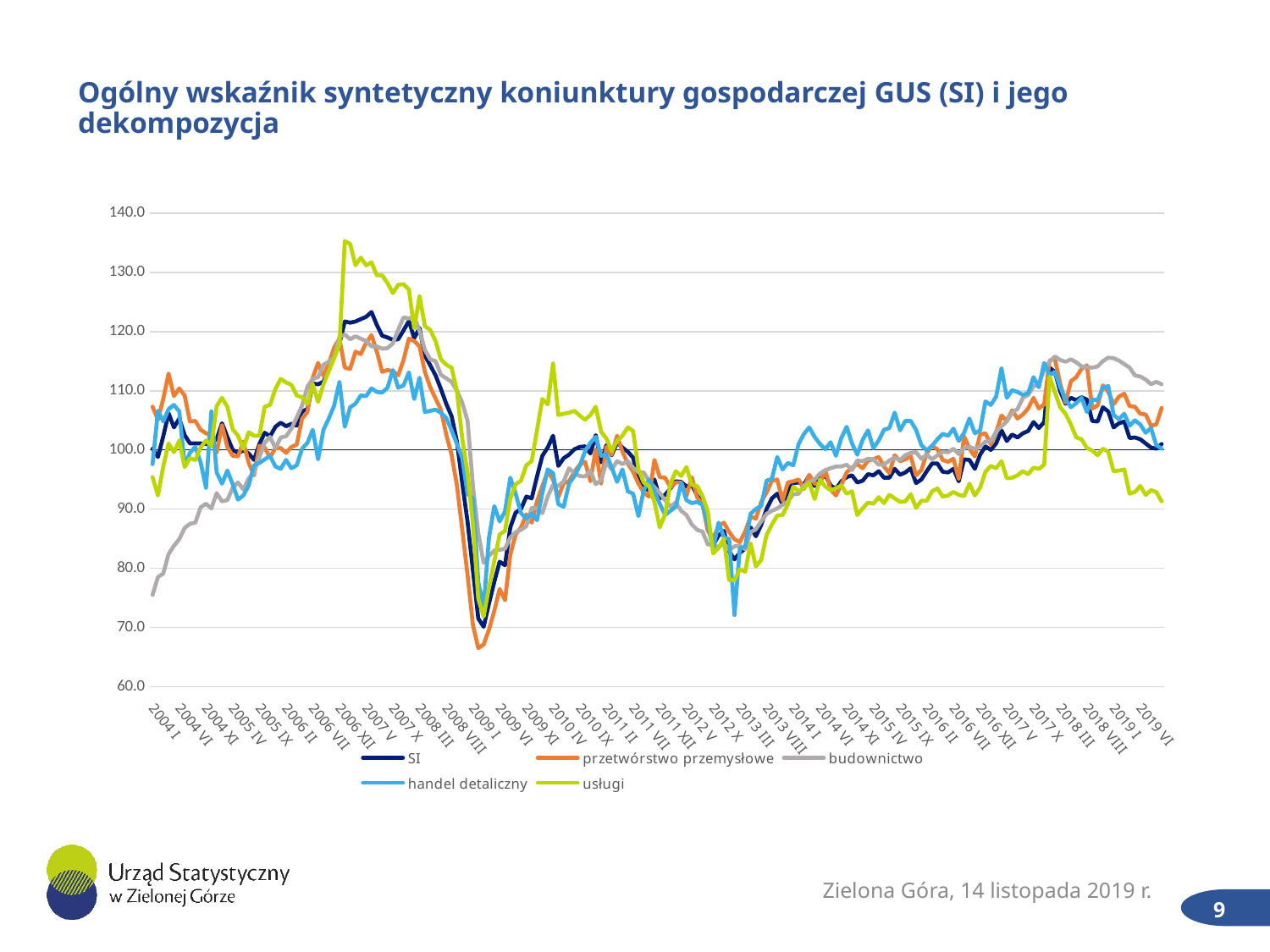
Does the budownictwo series rise or fall between 2004 I and 2006 XII? rise Is the lowest value of the przetwórstwo przemysłowe series around 2009 I greater or less than 70? less Does the SI series rise or fall between 2018 III and 2019 VI? fall Is the peak value of the usługi series around 2006 XII greater or less than 130? greater Which series is drawn in dark blue in the legend? SI Which series reaches the lowest value anywhere on the chart? przetwórstwo przemysłowe Which series reaches the highest value anywhere on the chart? usługi Is the value of the budownictwo series at 2004 I greater or less than 80? less What is the title of the chart on the slide? Ogólny wskaźnik syntetyczny koniunktury gospodarczej GUS (SI) i jego dekompozycja What kind of chart is shown on the slide? line chart How many series does the legend list? 5